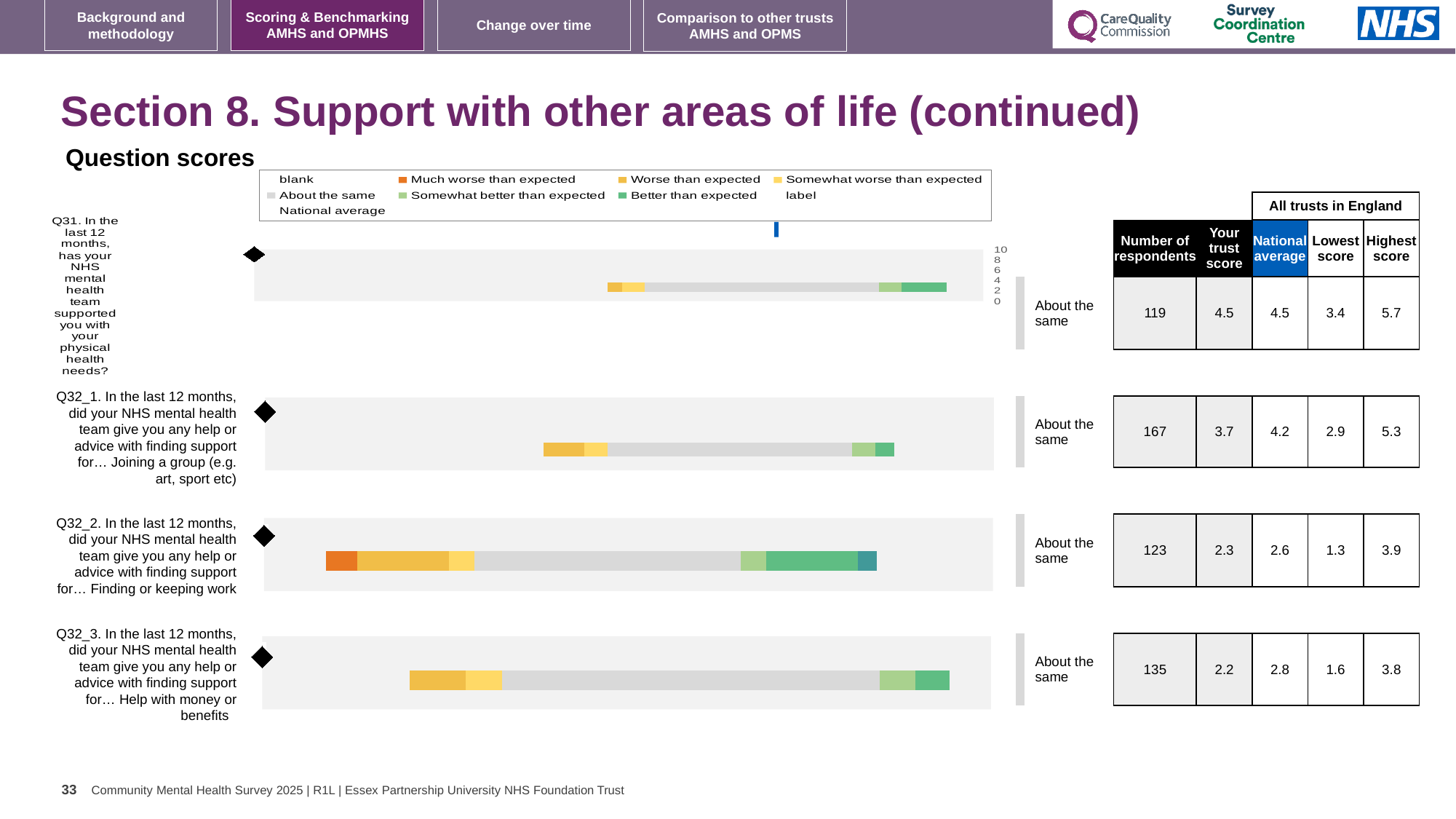
What is the 'Your trust score' value for Q31 (support with physical health needs)? 4.5 What is the difference between the Highest score and Lowest score for Q31? 2.3 Which question has the lowest 'Your trust score'? Q32_3 How many respondents are shown for Q32_2 (finding or keeping work)? 123 Which question has the highest 'Your trust score'? Q31 What is the difference between the National average and 'Your trust score' for Q32_1? 0.5 For Q32_2, which is larger: 'Your trust score' or the National average? National average What benchmark category label is shown next to each of the four question bars? About the same What is the Highest score among all trusts in England for Q32_3 (help with money or benefits)? 3.8 What kind of chart is used to show the question scores on this slide? Bar chart How many questions (bars) are shown in the Question scores chart? 4 What is the National average for Q32_1 (help with joining a group)? 4.2